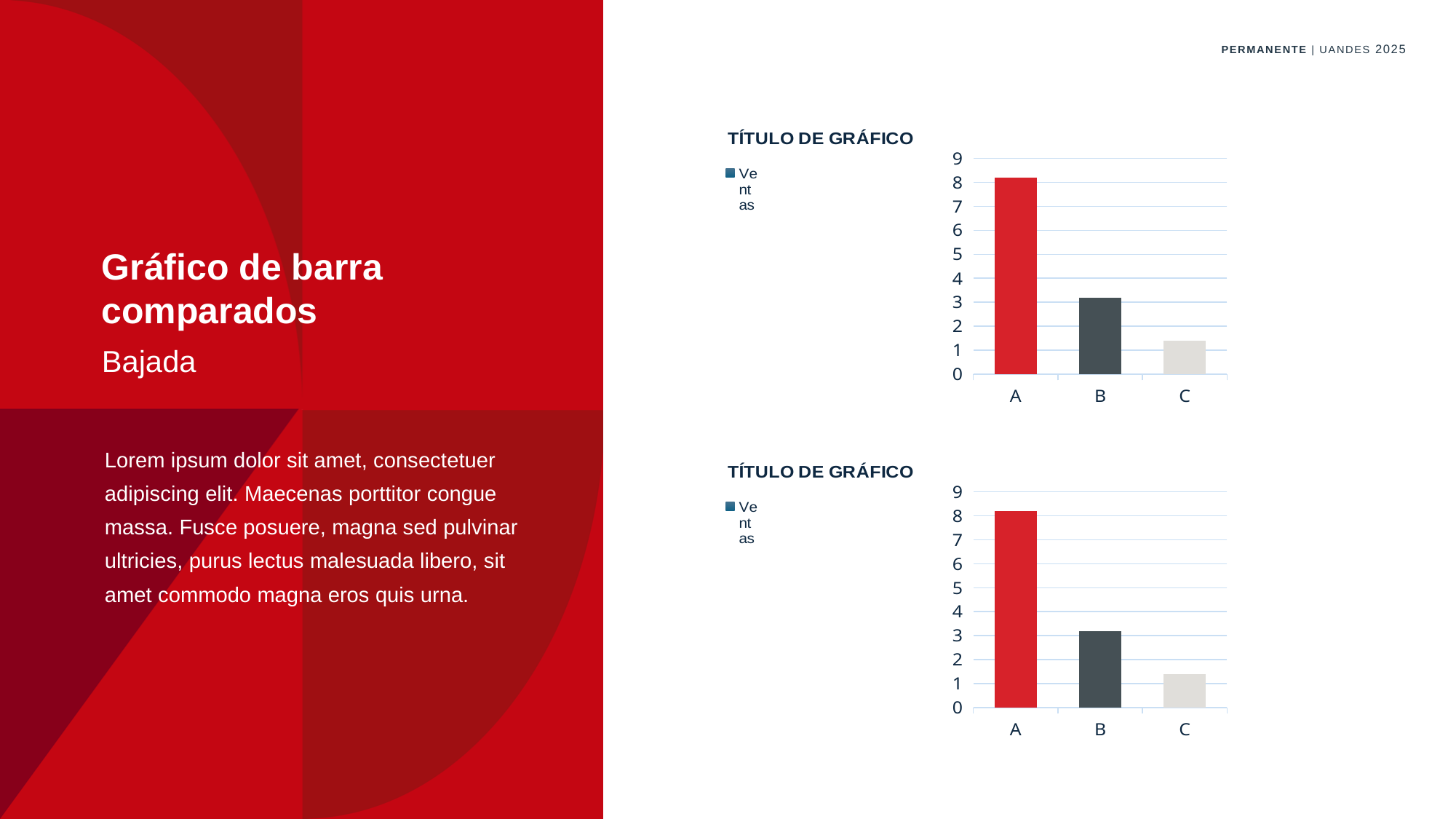
In the top chart, which category has the highest value? A In the top chart, do the values rise or fall from A to C? fall What kind of chart is the top chart on the slide? bar chart How many categories does the top chart show? 3 In the bottom chart, is the value for B greater or less than 4? less What is the name of the series shown in the legend of the top chart? Ventas How many series does the legend of the bottom chart list? 1 In the top chart, is the value for A greater or less than 8? greater In the bottom chart, which category has the lowest value? C What is the title of the bottom chart? TÍTULO DE GRÁFICO In the bottom chart, which is larger, the value for B or the value for C? B In the top chart, is the value for C greater or less than 2? less